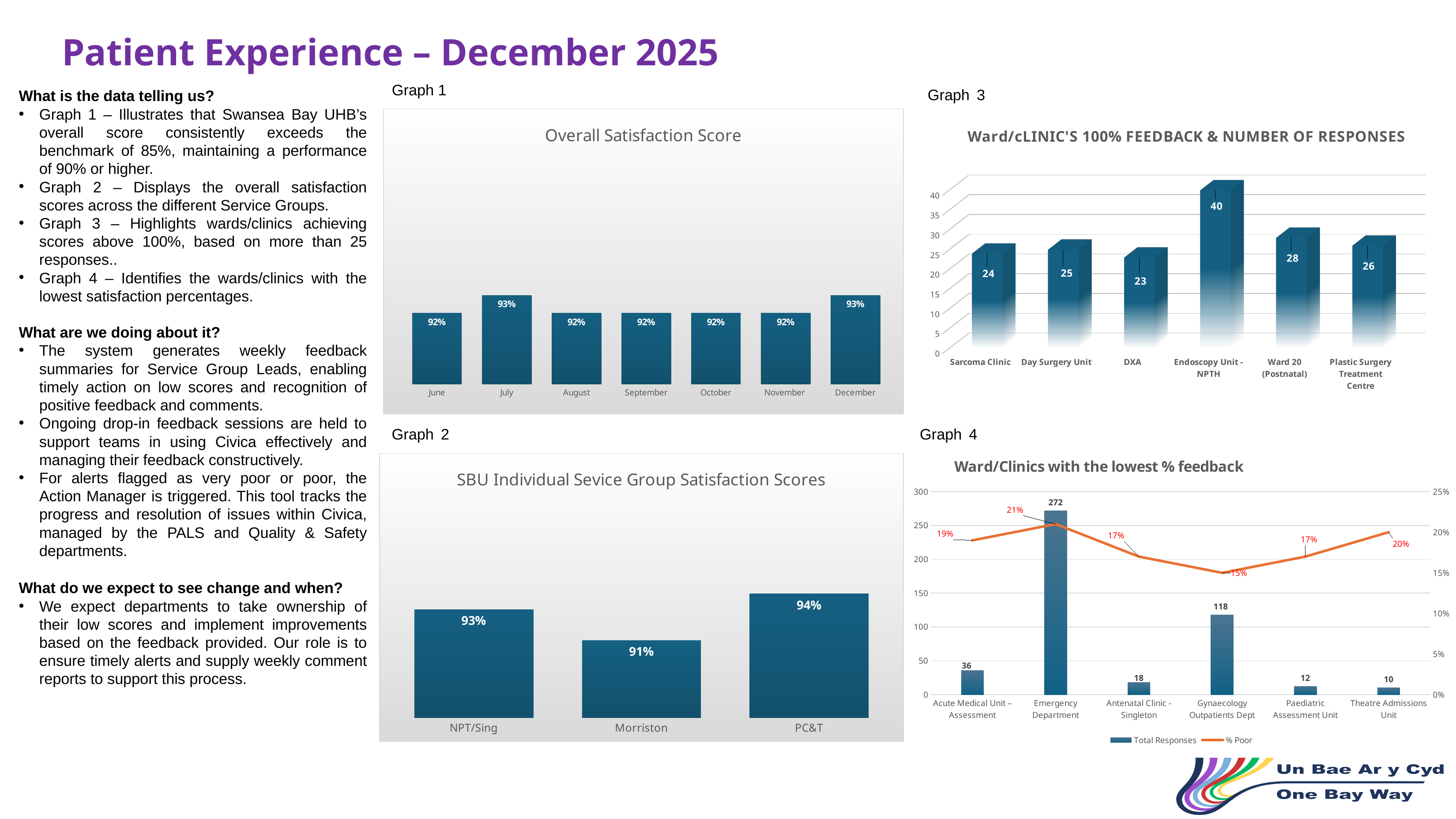
In the SBU Individual Service Group Satisfaction Scores chart (Graph 2), what is the value for PC&T? 94% In the Ward/Clinics with the lowest % feedback chart (Graph 4), what is the Total Responses value for Emergency Department? 272 In the Ward/Clinics with the lowest % feedback chart (Graph 4), how many series does the legend list? 2 In the SBU Individual Service Group Satisfaction Scores chart (Graph 2), which service group has the lowest score? Morriston In the Ward/Clinic's 100% Feedback & Number of Responses chart (Graph 3), what is the value for DXA? 23 In the Overall Satisfaction Score chart (Graph 1), what is the value for July? 93% In the Ward/Clinics with the lowest % feedback chart (Graph 4), what is the % Poor value for Gynaecology Outpatients Dept? 15% In the Overall Satisfaction Score chart (Graph 1), how many months are plotted? 7 In the Ward/Clinic's 100% Feedback & Number of Responses chart (Graph 3), what kind of chart is shown? Bar chart In the Ward/Clinic's 100% Feedback & Number of Responses chart (Graph 3), which ward/clinic has the highest number of responses? Endoscopy Unit - NPTH In the Ward/Clinics with the lowest % feedback chart (Graph 4), which has more Total Responses, Acute Medical Unit – Assessment or Antenatal Clinic - Singleton? Acute Medical Unit – Assessment In the SBU Individual Service Group Satisfaction Scores chart (Graph 2), what is the difference between the PC&T and Morriston scores? 3%